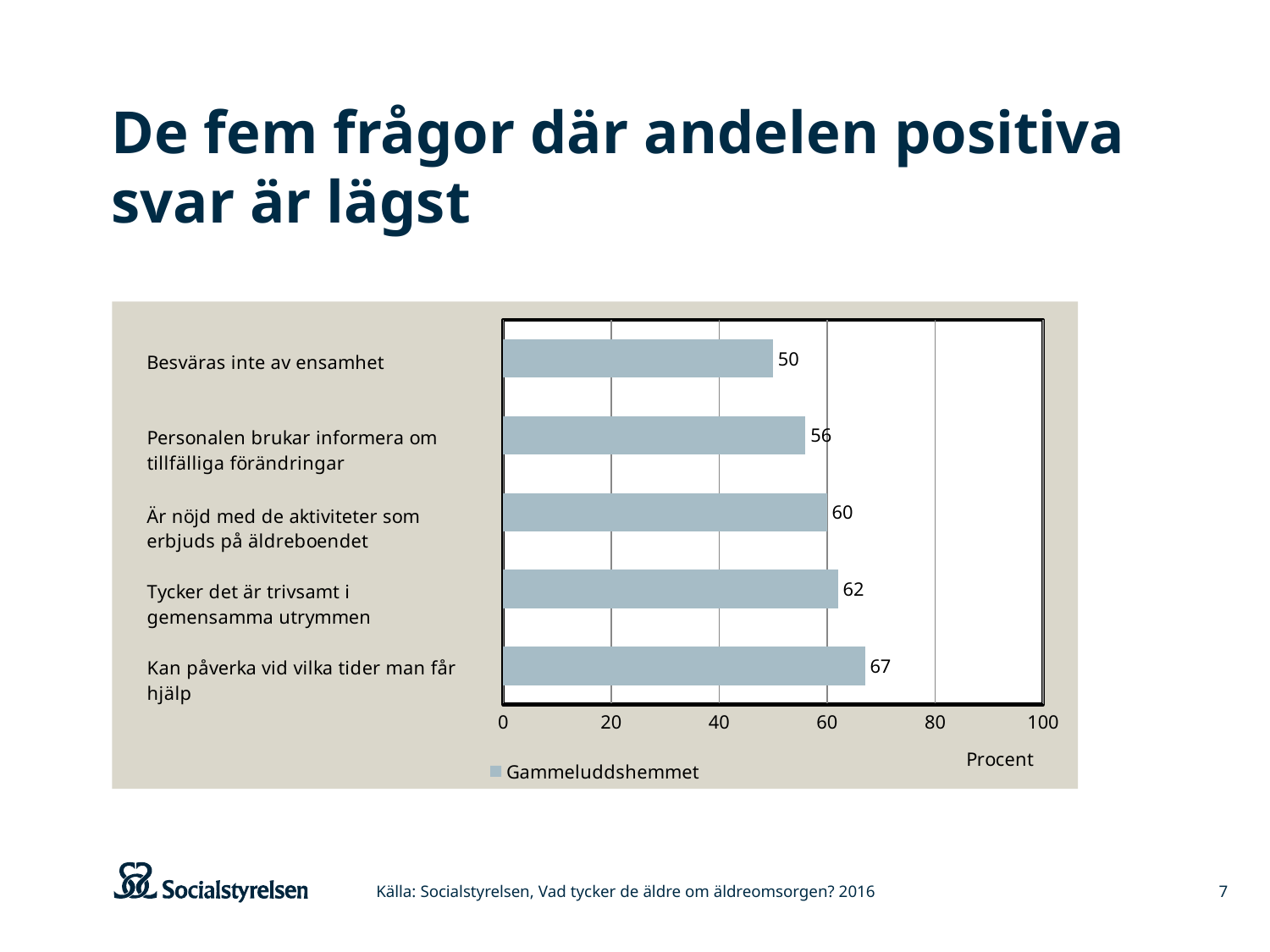
What is the value for "Är nöjd med de aktiviteter som erbjuds på äldreboendet"? 60 What is the value for "Kan påverka vid vilka tider man får hjälp"? 67 What is the difference between the values for "Kan påverka vid vilka tider man får hjälp" and "Besväras inte av ensamhet"? 17 How many categories are shown in the chart? 5 What is the value for "Besväras inte av ensamhet"? 50 Which is larger: the value for "Personalen brukar informera om tillfälliga förändringar" or the value for "Tycker det är trivsamt i gemensamma utrymmen"? Tycker det är trivsamt i gemensamma utrymmen How many series does the legend list? 1 Which category has the lowest value? Besväras inte av ensamhet What series name is shown in the chart legend? Gammeluddshemmet Which category has the highest value? Kan påverka vid vilka tider man får hjälp Is the value for "Personalen brukar informera om tillfälliga förändringar" greater or less than 60? less What kind of chart is shown on the slide? bar chart